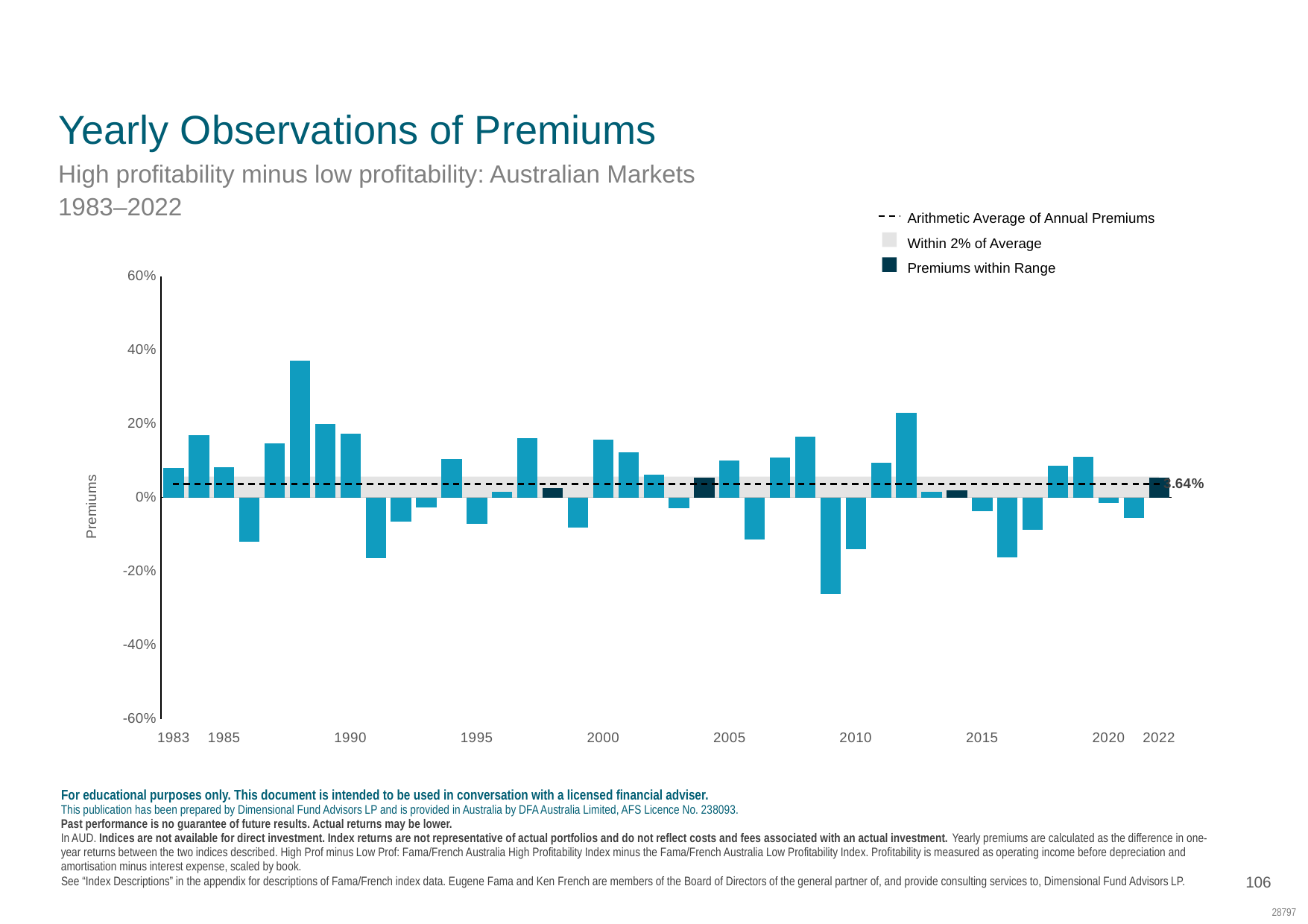
Is the value for 1991 greater or less than -10%? less What kind of chart is shown on the slide? Bar chart How many years of premiums are plotted on the chart? 40 Which year has the lowest premium? 2009 What is the label on the vertical axis of the chart? Premiums Is the value for 2009 greater or less than -20%? less Which year has the larger premium, 1988 or 1989? 1988 How many entries does the legend list? 3 What is the arithmetic average of annual premiums shown on the chart? 3.64% Is the value for 1988 greater or less than 20%? greater Which year has the highest premium? 1988